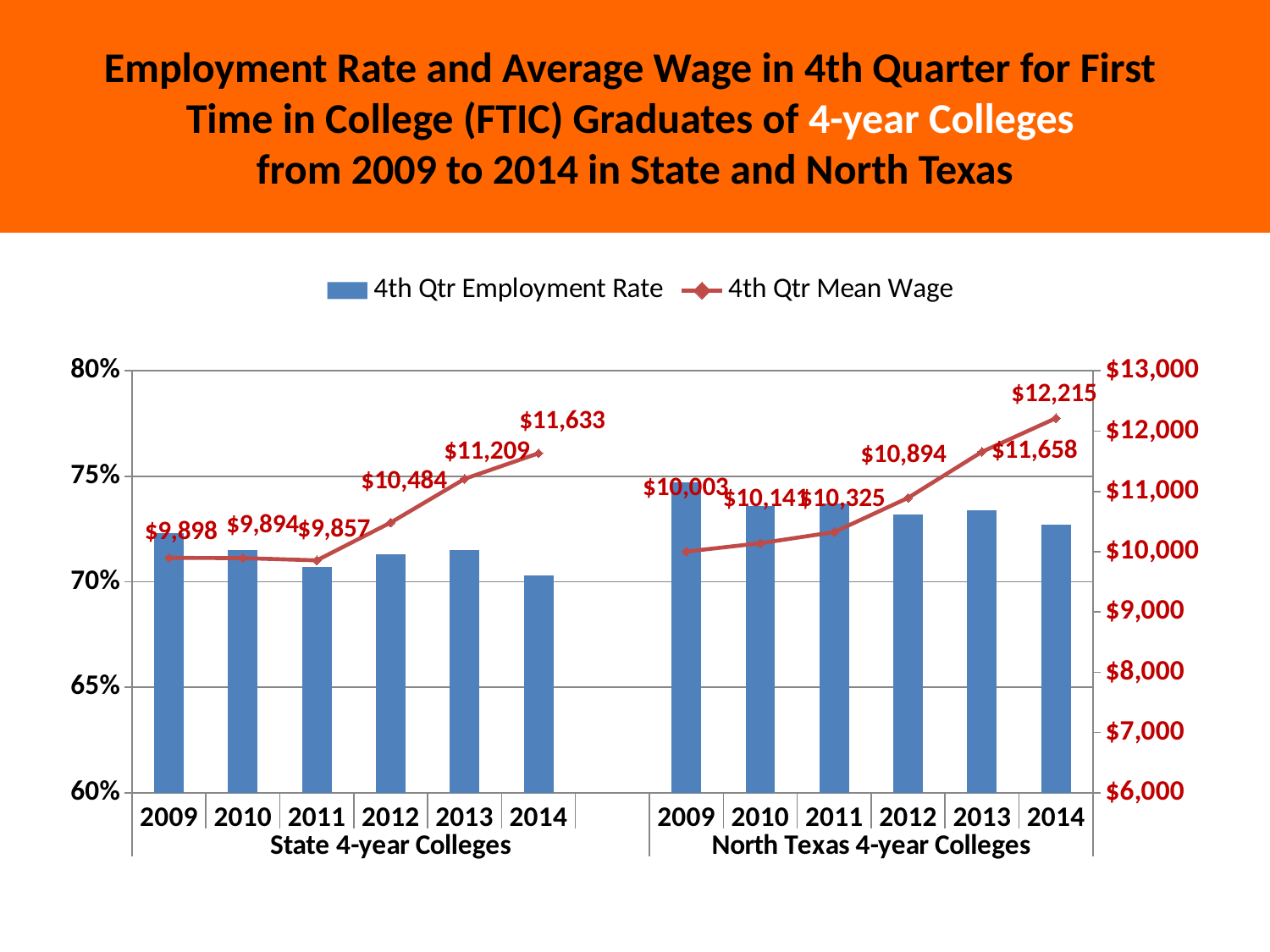
Is the 4th Qtr Employment Rate for State 4-year Colleges in 2009 greater or less than 70%? greater What is the 4th Qtr Mean Wage for North Texas 4-year Colleges in 2014? $12,215 What is the difference between the 2014 and 2009 4th Qtr Mean Wage for State 4-year Colleges? $1,735 How many bars are plotted on the chart in total? 12 Which year and group has the highest 4th Qtr Mean Wage on the chart? 2014, North Texas 4-year Colleges ($12,215) How much higher is the 4th Qtr Mean Wage for North Texas 4-year Colleges in 2014 than in 2013? $557 What is the 4th Qtr Mean Wage for State 4-year Colleges in 2013? $11,209 Does the 4th Qtr Mean Wage for North Texas 4-year Colleges rise or fall from 2009 to 2014? rise How many series does the legend list? 2 In 2012, which group has the higher 4th Qtr Mean Wage, State 4-year Colleges or North Texas 4-year Colleges? North Texas 4-year Colleges Is the 4th Qtr Employment Rate for North Texas 4-year Colleges in 2009 greater or less than 75%? less Which year has the lowest 4th Qtr Mean Wage among State 4-year Colleges? 2011 ($9,857)